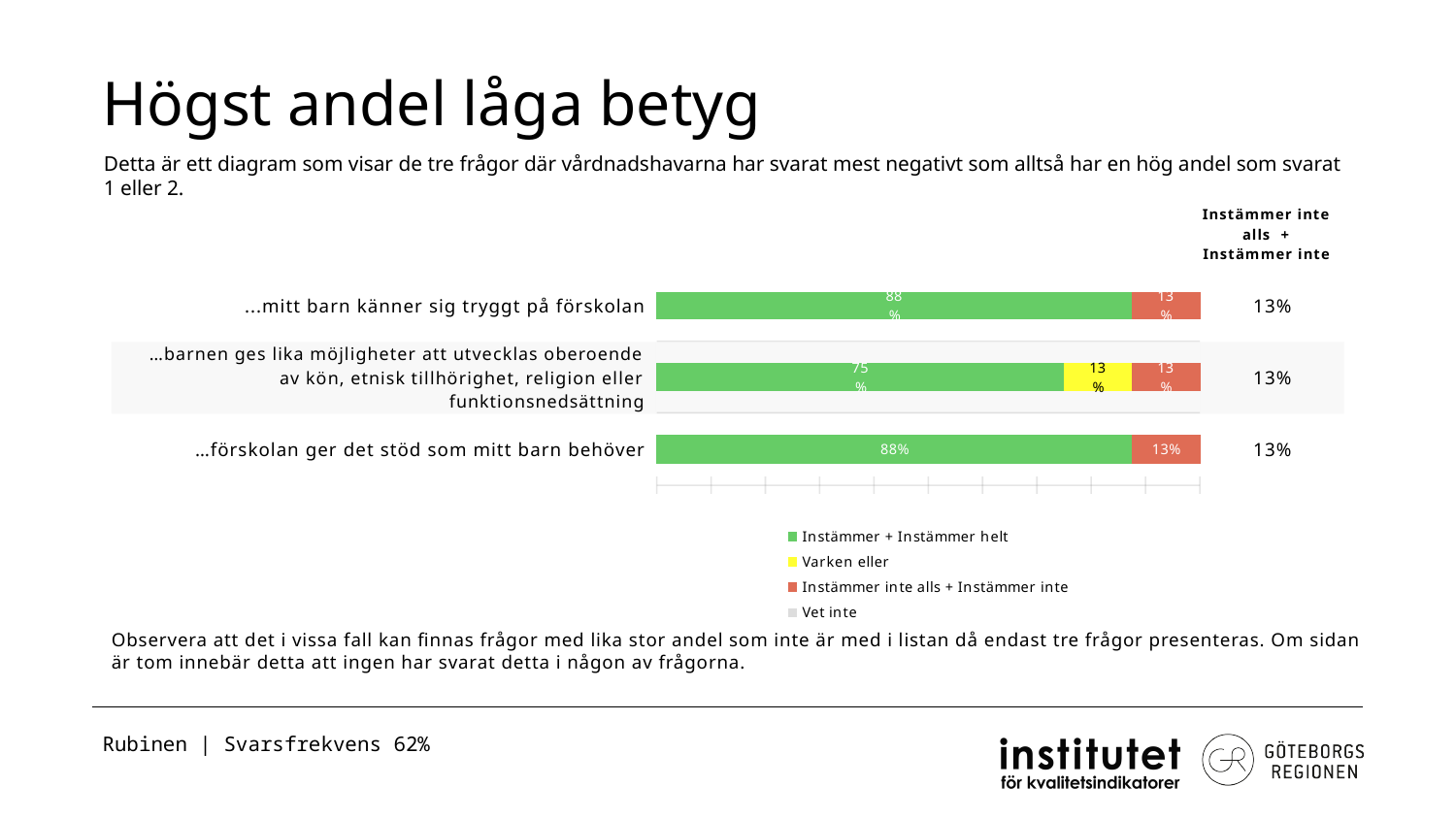
What is the value of "Varken eller" for "…barnen ges lika möjligheter att utvecklas oberoende av kön, etnisk tillhörighet, religion eller funktionsnedsättning"? 13% What kind of chart is shown on the slide? stacked bar chart What is the value of "Instämmer inte alls + Instämmer inte" for "…förskolan ger det stöd som mitt barn behöver"? 13% What is the difference in "Instämmer + Instämmer helt" between "…mitt barn känner sig tryggt på förskolan" and "…barnen ges lika möjligheter att utvecklas oberoende av kön, etnisk tillhörighet, religion eller funktionsnedsättning"? 13% What is the value of "Instämmer + Instämmer helt" for "…barnen ges lika möjligheter att utvecklas oberoende av kön, etnisk tillhörighet, religion eller funktionsnedsättning"? 75% How many questions (categories) are shown in the chart? 3 Which question has the lowest value for "Instämmer + Instämmer helt"? …barnen ges lika möjligheter att utvecklas oberoende av kön, etnisk tillhörighet, religion eller funktionsnedsättning How many series does the legend list? 4 Which colour represents "Varken eller" in the legend? yellow What is the value of "Instämmer + Instämmer helt" for "…mitt barn känner sig tryggt på förskolan"? 88% What value is shown in the "Instämmer inte alls + Instämmer inte" column to the right of the chart for "…mitt barn känner sig tryggt på förskolan"? 13% Which has a larger "Instämmer + Instämmer helt" value: "…förskolan ger det stöd som mitt barn behöver" or "…barnen ges lika möjligheter att utvecklas oberoende av kön, etnisk tillhörighet, religion eller funktionsnedsättning"? …förskolan ger det stöd som mitt barn behöver